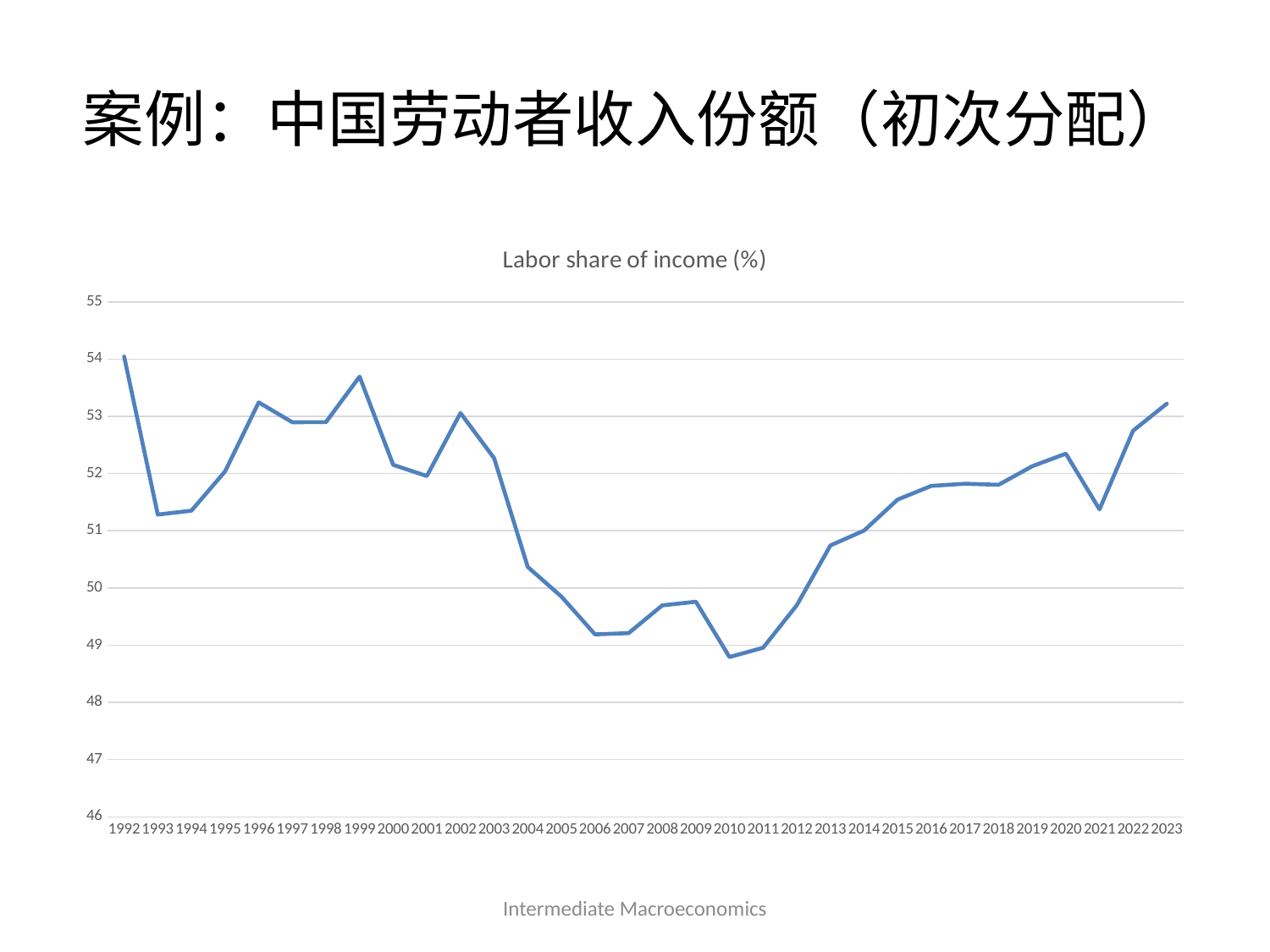
Is the value for 2023 greater or less than 52? greater How many years are plotted along the x axis? 32 Is the value for 2016 greater or less than 51? greater Which is larger, the value for 2006 or the value for 2013? 2013 What kind of chart is shown on the slide? line chart Is the value for 2010 greater or less than 49? less Does the labor share of income rise or fall from 2002 to 2006? fall Which year has the highest labor share of income? 1992 What is the title of the chart? Labor share of income (%) Which is larger, the value for 1992 or the value for 2023? 1992